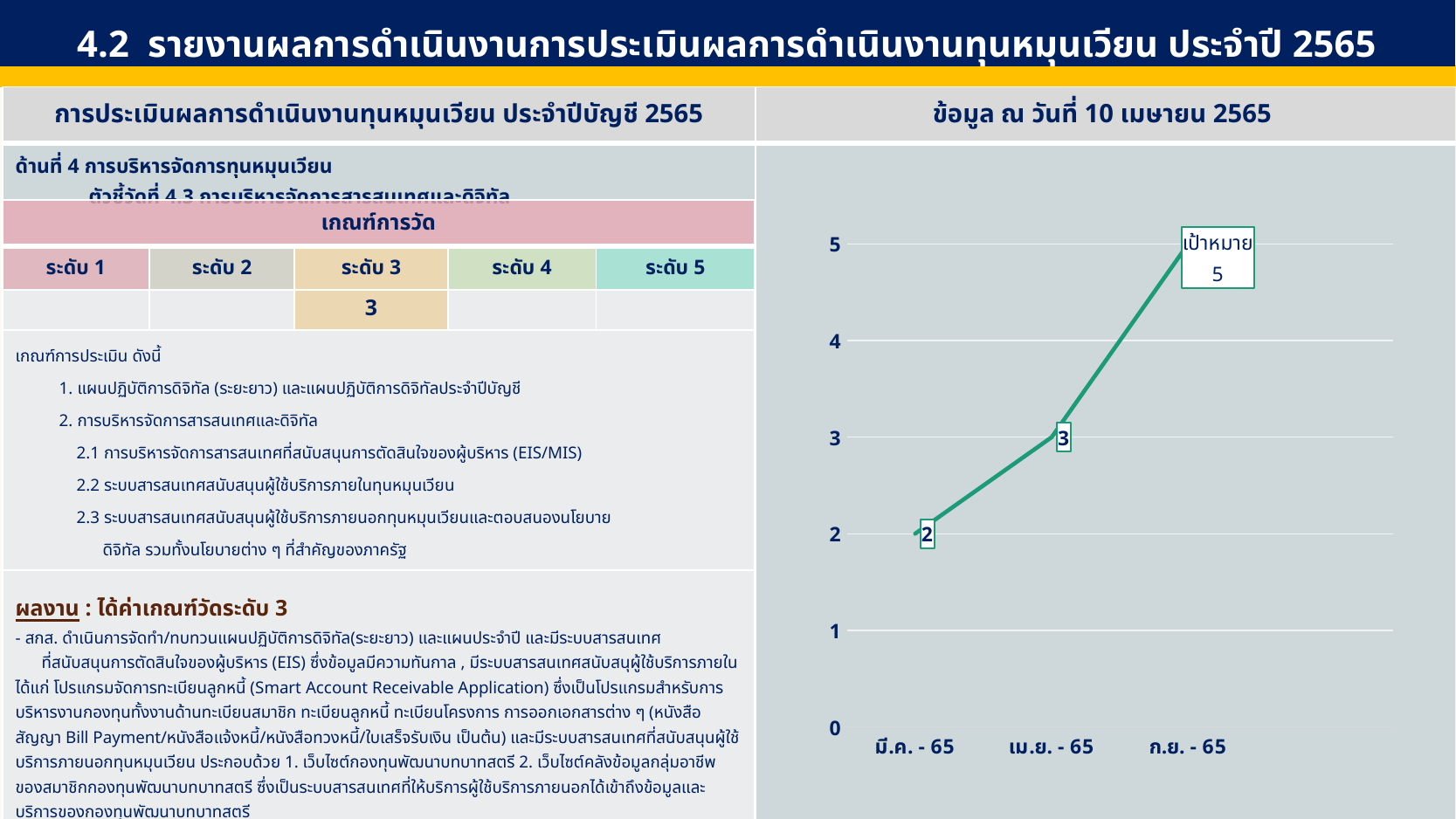
What type of chart is shown on the right side of the slide? line chart What is the value plotted for มี.ค. - 65? 2 What is the value plotted for เม.ย. - 65? 3 What is the difference between the values for ก.ย. - 65 and มี.ค. - 65? 3 What label is shown in the box next to the ก.ย. - 65 data point? เป้าหมาย 5 Which is larger, the value for เม.ย. - 65 or the value for มี.ค. - 65? เม.ย. - 65 Which x-axis category has the lowest value? มี.ค. - 65 What is the value plotted for ก.ย. - 65? 5 How many data points are plotted on the line chart? 3 Do the values rise or fall from มี.ค. - 65 to ก.ย. - 65? rise Which x-axis category has the highest value? ก.ย. - 65 What is the difference between the values for เม.ย. - 65 and มี.ค. - 65? 1